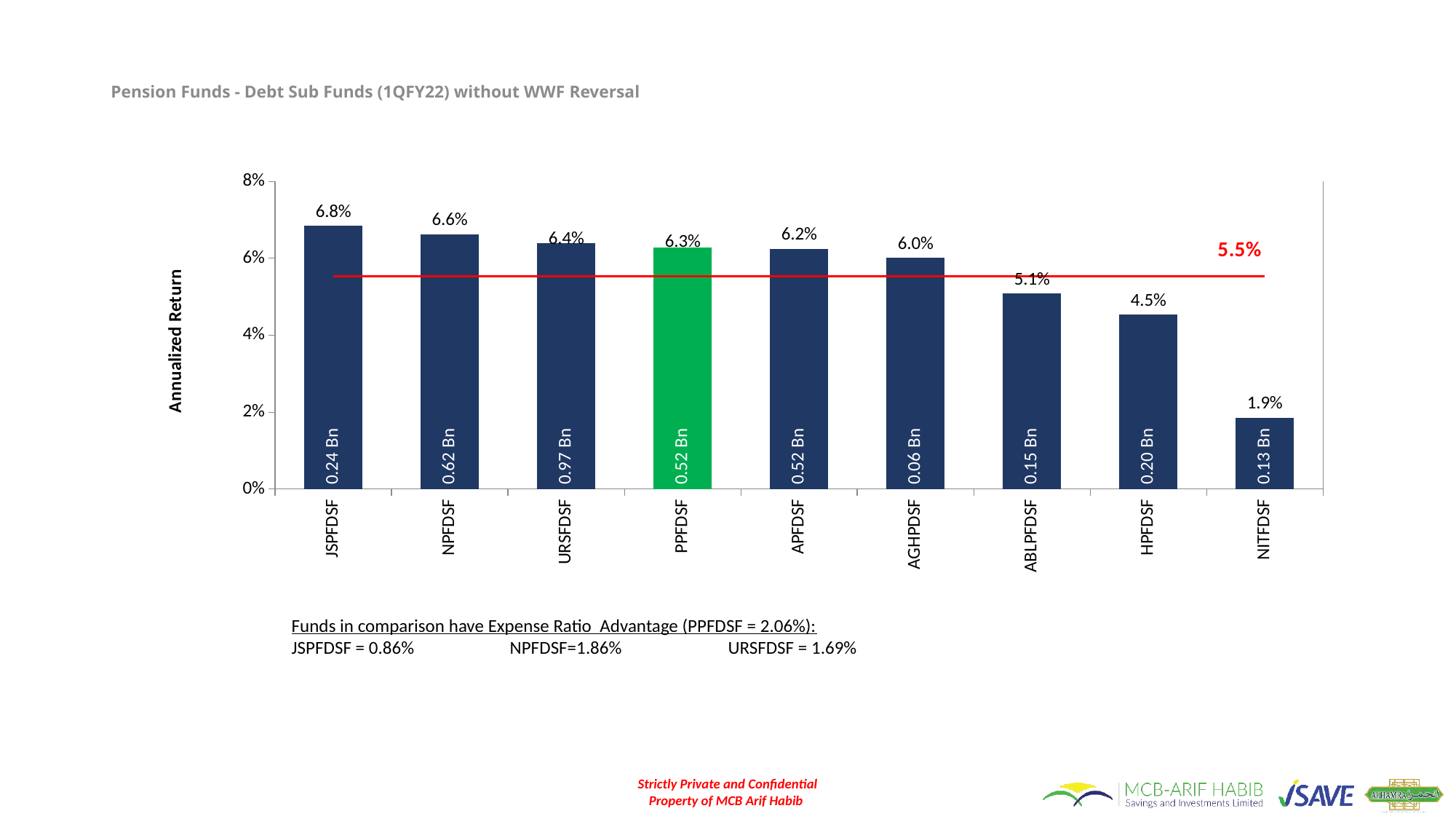
Which fund has the highest annualized return? JSPFDSF Which has a higher annualized return, AGHPDSF or ABLPFDSF? AGHPDSF What is the difference in annualized return between JSPFDSF and HPFDSF? 2.3% What is the annualized return for NITFDSF? 1.9% Do the annualized returns rise or fall moving from left to right along the x axis? fall What value is labelled on the red horizontal line? 5.5% How many funds are shown on the chart? 9 Which fund has the lowest annualized return? NITFDSF Is the annualized return for ABLPFDSF greater or less than 6%? less What kind of chart is shown on the slide? bar chart What fund size is printed inside the URSFDSF bar? 0.97 Bn What is the annualized return for PPFDSF? 6.3%